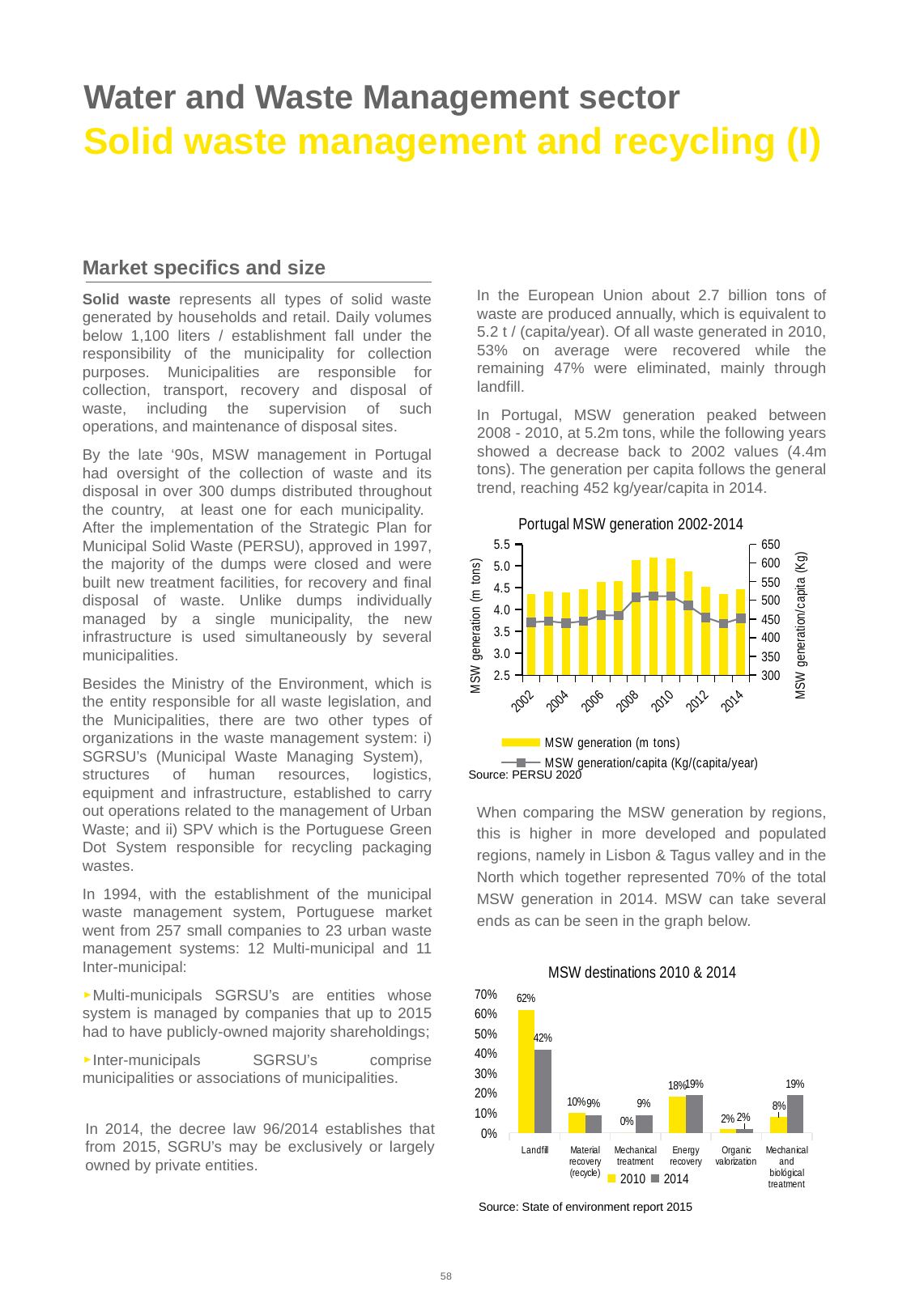
How many series does the legend of the 'Portugal MSW generation 2002-2014' chart list? 2 How many destination categories are shown in the 'MSW destinations 2010 & 2014' chart? 6 In the 'MSW destinations 2010 & 2014' chart, which destination has the lowest value in 2010? Mechanical treatment In the 'Portugal MSW generation 2002-2014' chart, is the MSW generation (m tons) bar for 2008 greater or less than 5.0? greater In the 'MSW destinations 2010 & 2014' chart, which destination has the highest value in 2014? Landfill In the 'MSW destinations 2010 & 2014' chart, by how many percentage points did the Landfill share fall from 2010 to 2014? 20 percentage points In the 'MSW destinations 2010 & 2014' chart, which is larger: Energy recovery in 2014 or Material recovery (recycle) in 2014? Energy recovery in 2014 In the 'MSW destinations 2010 & 2014' chart, what is the value for Mechanical treatment in 2010? 0% In the 'Portugal MSW generation 2002-2014' chart, is the MSW generation (m tons) bar for 2011 greater or less than 4.5? greater In the 'MSW destinations 2010 & 2014' chart, what is the value for Landfill in 2010? 62% What kind of chart is the 'MSW destinations 2010 & 2014' chart? Bar chart In the 'MSW destinations 2010 & 2014' chart, what is the value for Mechanical and biological treatment in 2014? 19%